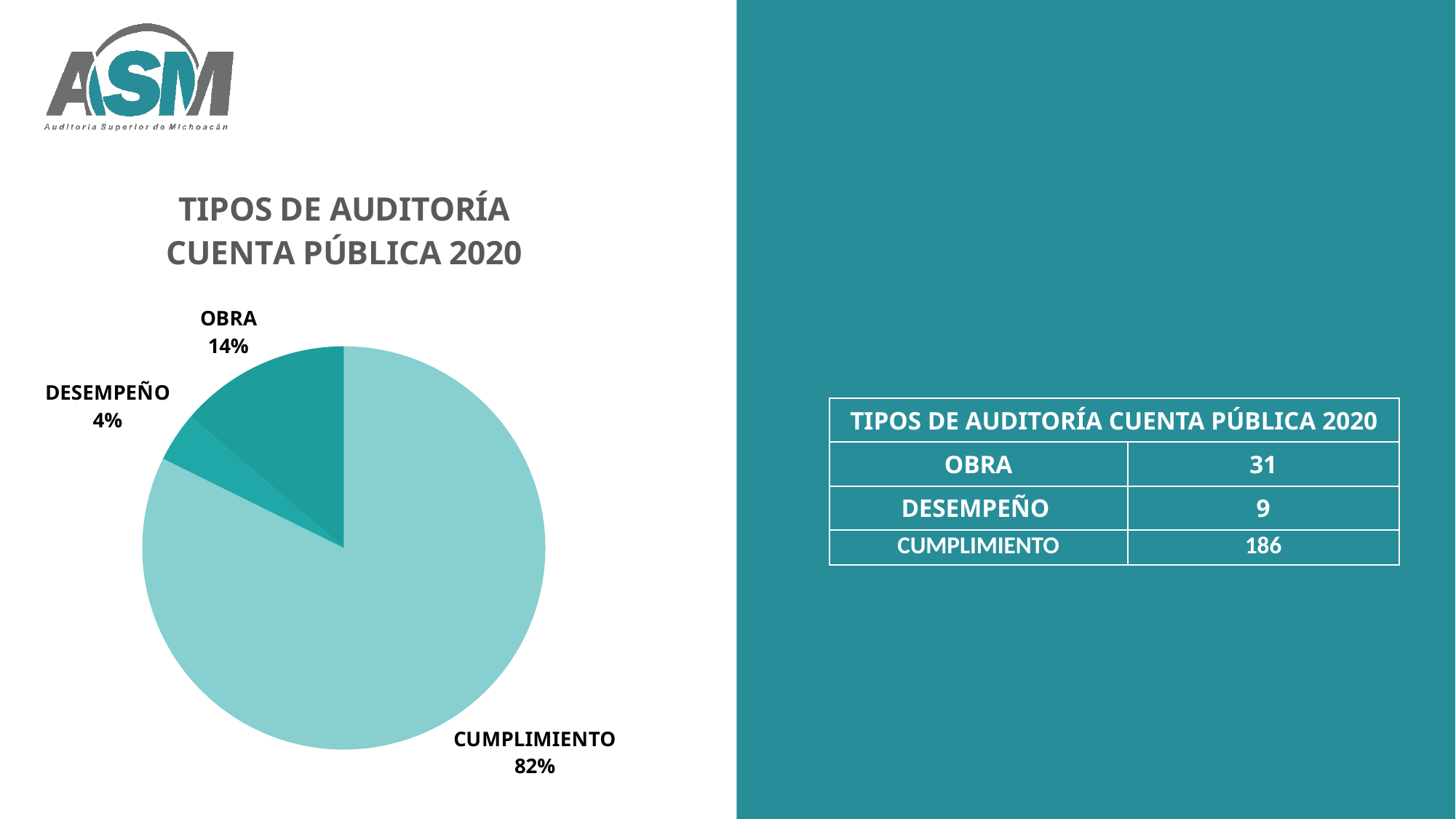
What percentage of the pie does DESEMPEÑO represent? 4% What is the title of the chart? TIPOS DE AUDITORÍA CUENTA PÚBLICA 2020 What percentage of the pie does OBRA represent? 14% Which category has the smallest slice of the pie? DESEMPEÑO How many slices does the pie chart have? 3 Which slice is larger, OBRA or DESEMPEÑO? OBRA What is the difference in percentage points between the CUMPLIMIENTO and OBRA slices? 68 What percentage of the pie does CUMPLIMIENTO represent? 82% What is the difference in percentage points between the OBRA and DESEMPEÑO slices? 10 Which category has the largest slice of the pie? CUMPLIMIENTO What type of chart is shown on the slide? pie chart Which slice of the pie is drawn in the lightest shade of teal? CUMPLIMIENTO